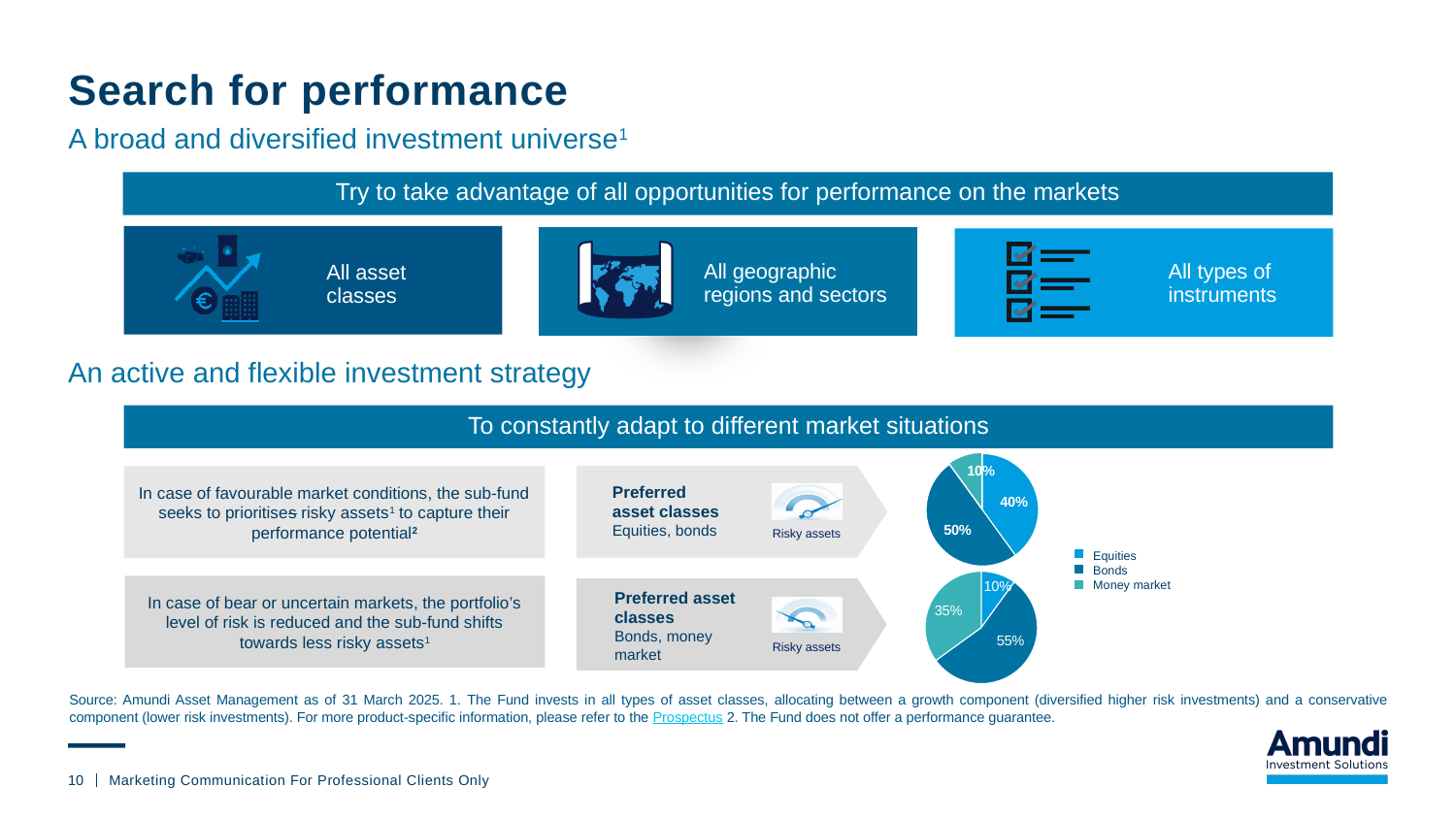
Which legend entry is shown in the lightest blue colour? Money market In the bottom pie chart, what is the smallest slice's share? 10% In the top pie chart, what share is shown for Equities? 40% In the bottom pie chart, what is the difference between the 55% slice and the 35% slice? 20% How many entries does the legend next to the pie charts list? 3 How many pie charts are shown on the slide? 2 In the bottom pie chart, what is the largest slice's share? 55% In the top pie chart, what is the difference between the 50% slice and the 40% slice? 10% What kind of chart is used to show the asset allocations on the slide? Pie chart In the top pie chart, what is the smallest slice's share? 10% In the top pie chart, what is the largest slice's share? 50% How many slices does each pie chart have? 3